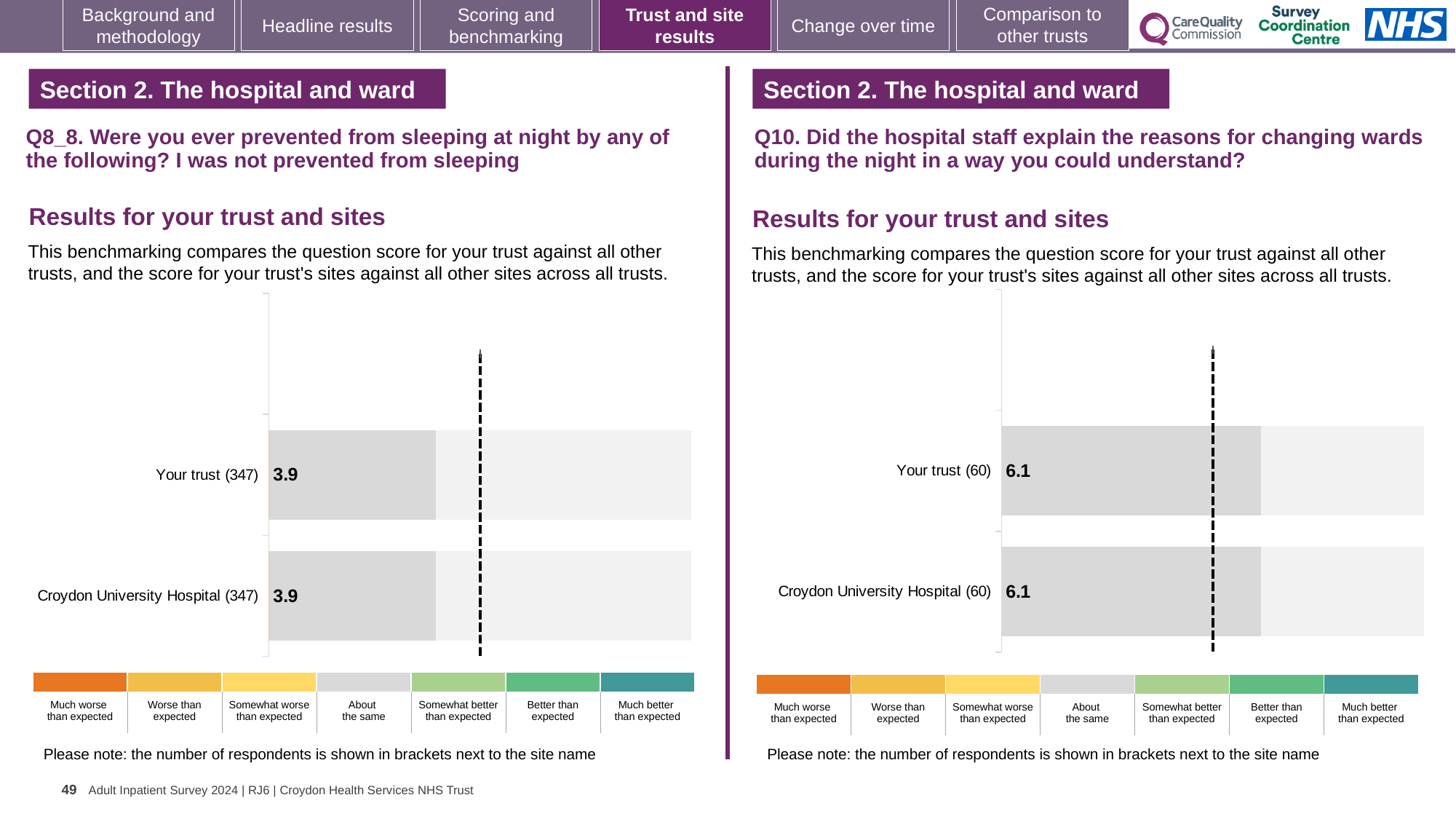
On the left chart (Q8_8), what is the score for Croydon University Hospital? 3.9 Is the score for Your trust on the right chart (Q10) larger or smaller than the score for Your trust on the left chart (Q8_8)? Larger On the right chart (Q10), what is the score for Your trust? 6.1 On the left chart (Q8_8), how many respondents are shown in brackets for Your trust? 347 How many bars are plotted on the left chart (Q8_8)? 2 What kind of chart is used on the left (Q8_8)? Bar chart On the right chart (Q10), how many respondents are shown in brackets for Croydon University Hospital? 60 On the left chart (Q8_8), what is the score for Your trust? 3.9 On the right chart (Q10), what is the difference between the score for Your trust and the score for Croydon University Hospital? 0 On the left chart (Q8_8), what is the difference between the score for Your trust and the score for Croydon University Hospital? 0 How many bars are plotted on the right chart (Q10)? 2 On the right chart (Q10), what is the score for Croydon University Hospital? 6.1